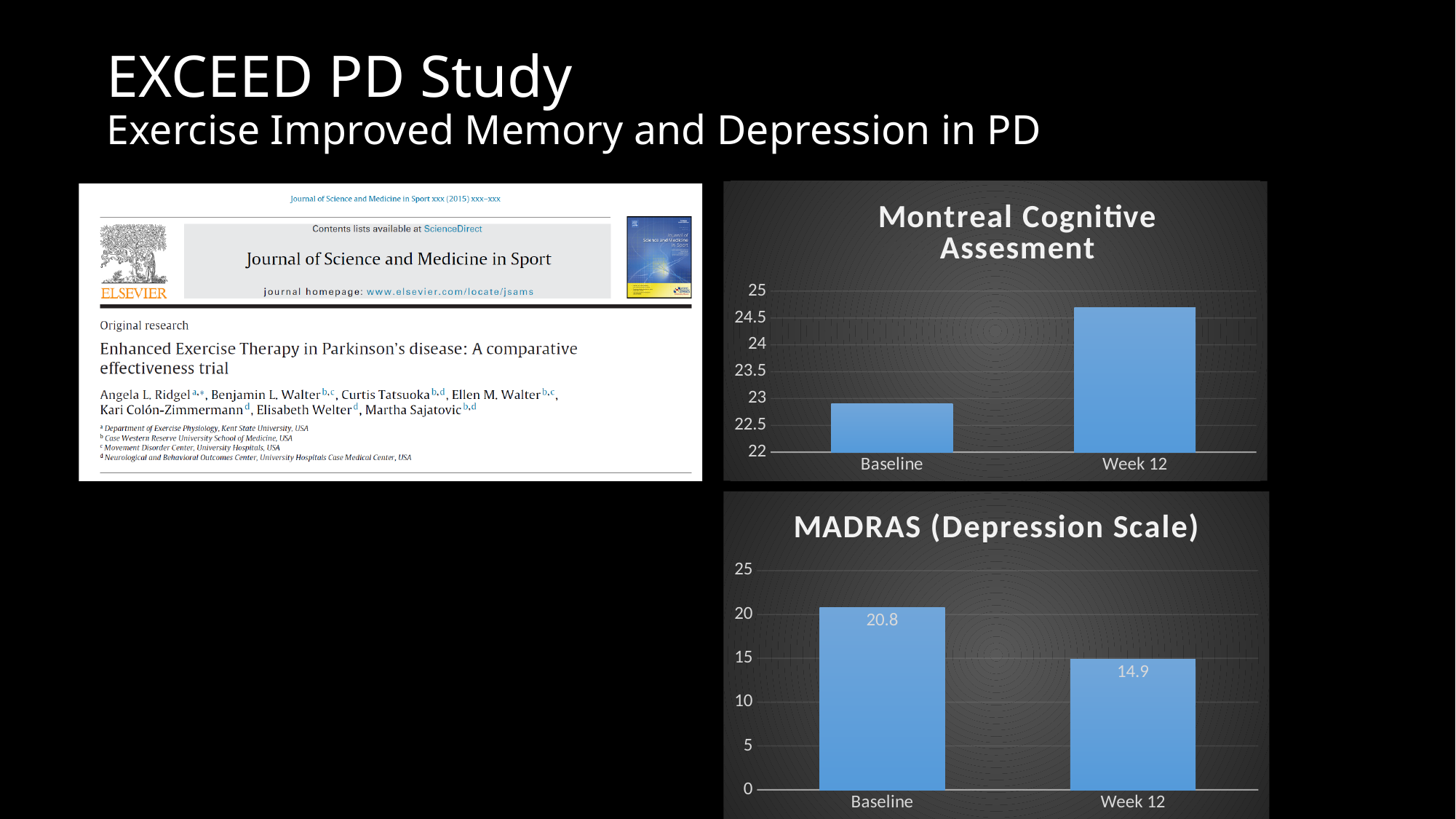
In the MADRAS (Depression Scale) chart, what is the difference between the Baseline and Week 12 values? 5.9 In the MADRAS (Depression Scale) chart, do the values rise or fall from Baseline to Week 12? fall In the Montreal Cognitive Assesment chart, which category has the higher value? Week 12 In the Montreal Cognitive Assesment chart, do the values rise or fall from Baseline to Week 12? rise What is the title of the lower chart on the slide? MADRAS (Depression Scale) In the Montreal Cognitive Assesment chart, is the value for Week 12 greater or less than 24? greater How many categories are shown in the Montreal Cognitive Assesment chart? 2 In the MADRAS (Depression Scale) chart, which category has the lower value? Week 12 In the MADRAS (Depression Scale) chart, what is the value for Week 12? 14.9 In the MADRAS (Depression Scale) chart, what is the value for Baseline? 20.8 What kind of chart is the MADRAS (Depression Scale) chart? bar chart